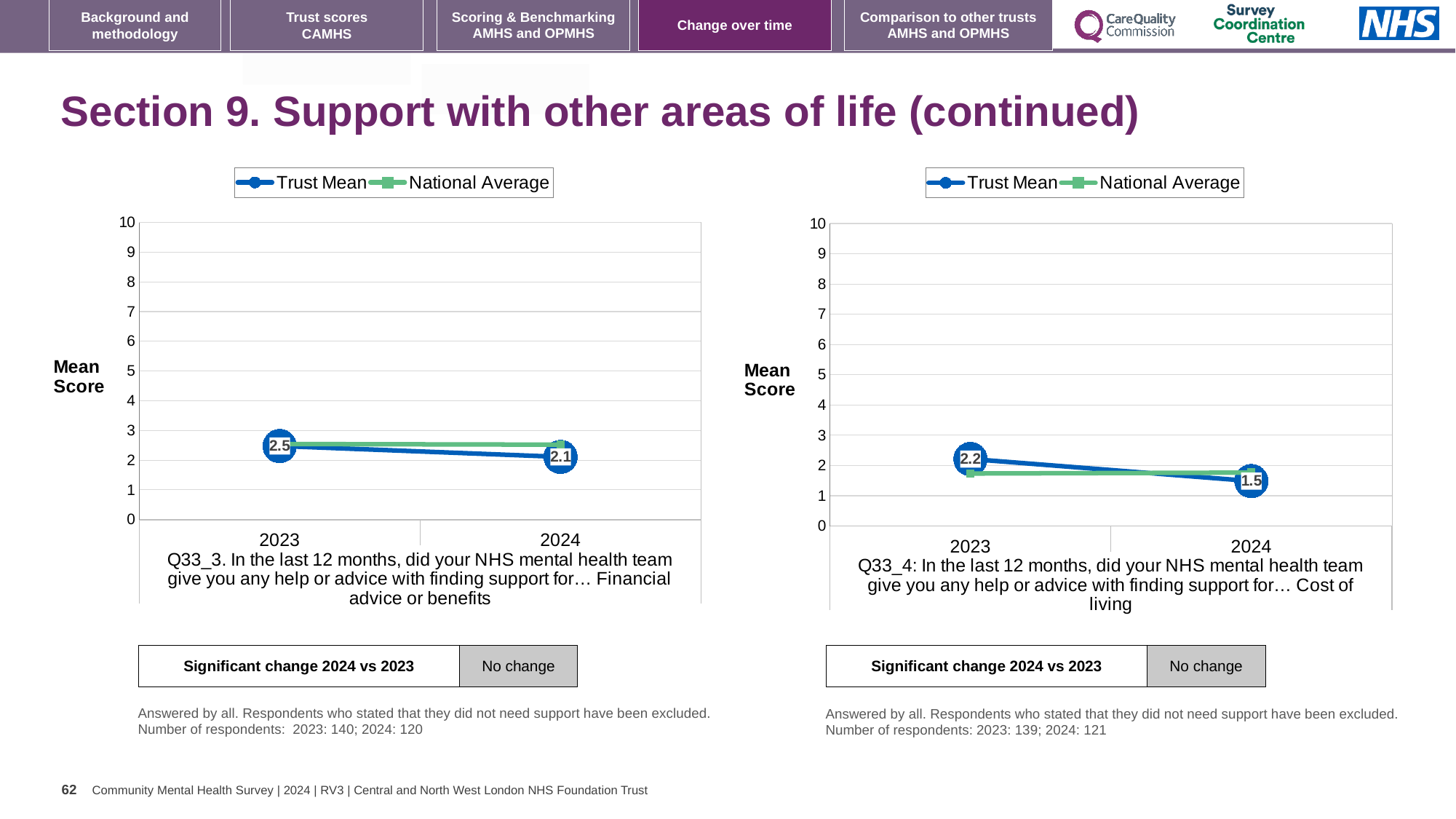
In the right chart (Q33_4), which is larger in 2023: the Trust Mean or the National Average? Trust Mean In the right chart (Q33_4, Cost of living), what is the Trust Mean for 2024? 1.5 In the left chart (Q33_3), is the National Average for 2023 greater or less than 5? less In the left chart (Q33_3), by how much did the Trust Mean change from 2023 to 2024? 0.4 How many series does the legend of the right chart (Q33_4) list? 2 In the left chart (Q33_3, Financial advice or benefits), what is the Trust Mean for 2024? 2.1 In the right chart (Q33_4), what is the difference between the Trust Mean in 2023 and in 2024? 0.7 In the left chart (Q33_3, Financial advice or benefits), what is the Trust Mean for 2023? 2.5 In the right chart (Q33_4), does the Trust Mean rise or fall from 2023 to 2024? fall In the right chart (Q33_4, Cost of living), what is the Trust Mean for 2023? 2.2 How many years are plotted on the x axis of the left chart (Q33_3)? 2 What type of chart is the left chart (Q33_3)? line chart